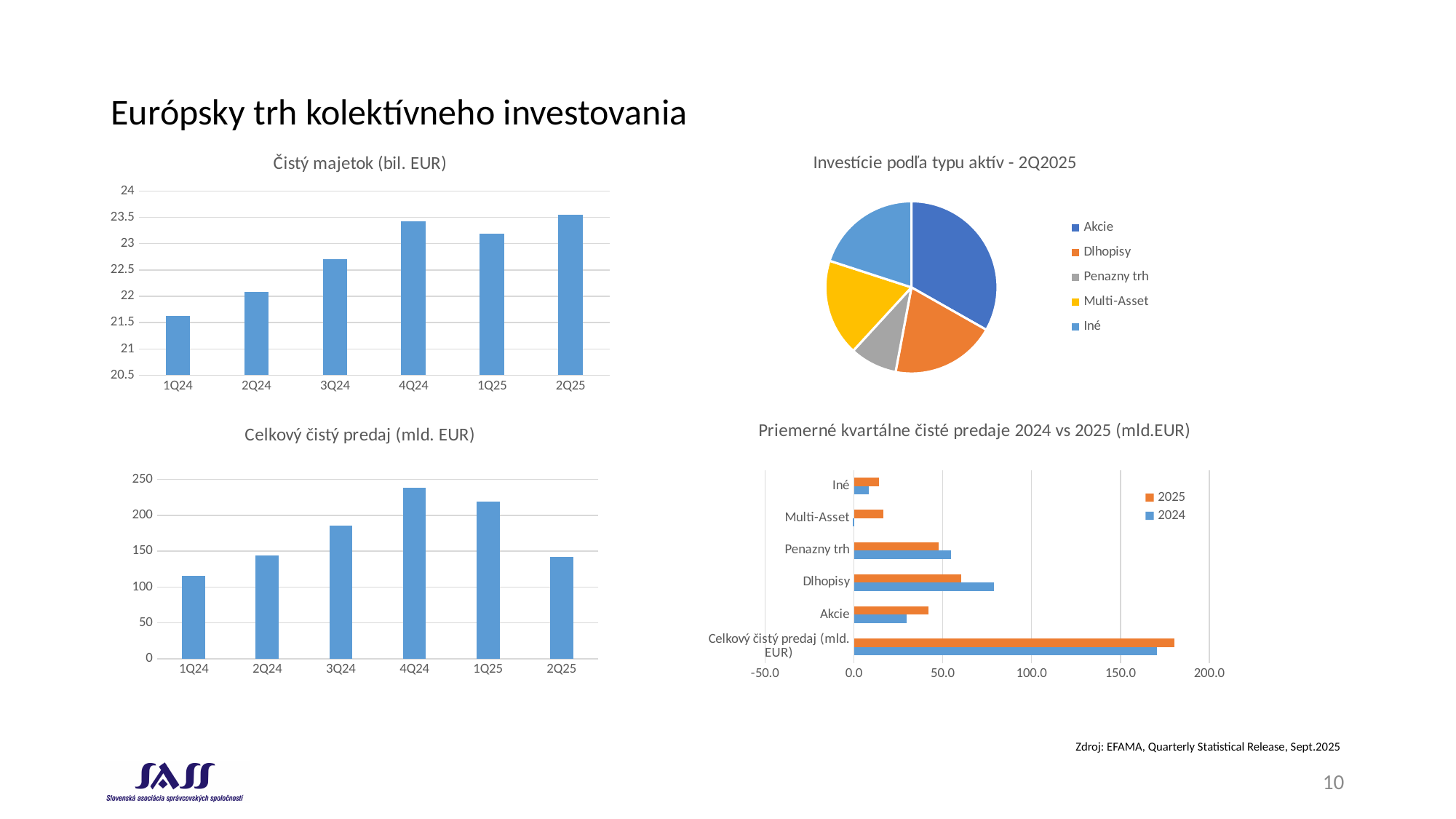
What kind of chart is "Investície podľa typu aktív - 2Q2025"? pie chart In the pie chart "Investície podľa typu aktív - 2Q2025", which asset type has the largest slice? Akcie In the chart titled "Celkový čistý predaj (mld. EUR)", is the value for 1Q25 greater or less than 200? greater In the chart titled "Priemerné kvartálne čisté predaje 2024 vs 2025 (mld.EUR)", for Dlhopisy, which year has the larger value, 2024 or 2025? 2024 In the chart titled "Čistý majetok (bil. EUR)", which quarter has the lowest value? 1Q24 In the pie chart "Investície podľa typu aktív - 2Q2025", which asset type has the smallest slice? Penazny trh In the chart titled "Čistý majetok (bil. EUR)", is the value for 4Q24 greater or less than 23? greater In the chart titled "Celkový čistý predaj (mld. EUR)", which is larger, 3Q24 or 1Q24? 3Q24 How many quarters are shown in the chart titled "Čistý majetok (bil. EUR)"? 6 How many series does the legend list in the chart titled "Priemerné kvartálne čisté predaje 2024 vs 2025 (mld.EUR)"? 2 In the chart titled "Celkový čistý predaj (mld. EUR)", which quarter has the highest value? 4Q24 In the chart titled "Čistý majetok (bil. EUR)", is the value for 1Q24 greater or less than 22? less